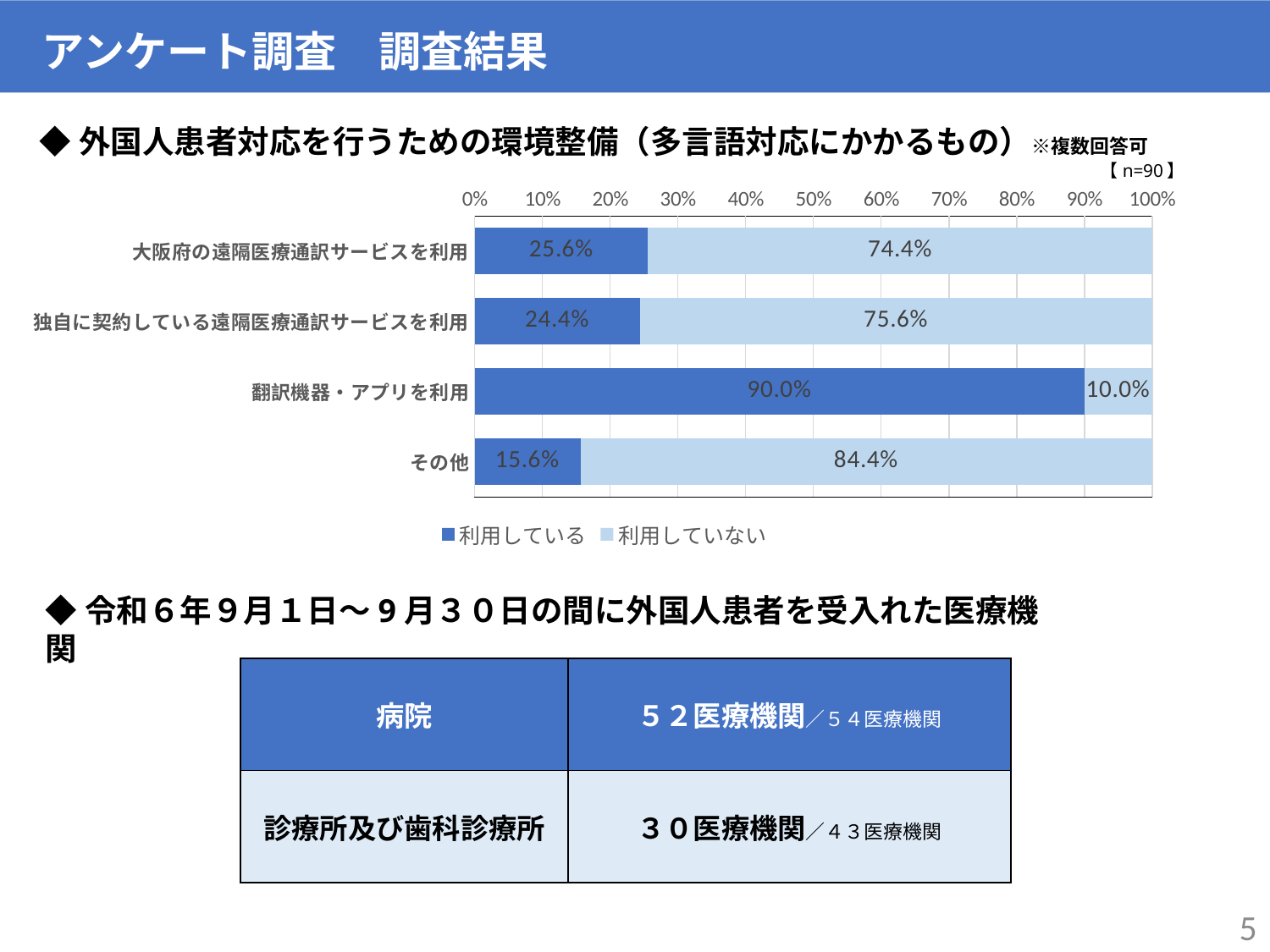
What is the 利用していない value for 大阪府の遠隔医療通訳サービスを利用? 74.4% How many categories are shown in the bar chart? 4 Which category has the highest 利用している share? 翻訳機器・アプリを利用 Which category has the lowest 利用している share? その他 What is the sample size (n) shown for the chart? n=90 What is the 利用していない value for 独自に契約している遠隔医療通訳サービスを利用? 75.6% What type of chart is shown on the slide? Stacked bar chart What is the difference between the 利用している values for 大阪府の遠隔医療通訳サービスを利用 and 独自に契約している遠隔医療通訳サービスを利用? 1.2% What is the 利用している value for その他? 15.6% What percentage of respondents use 翻訳機器・アプリ (利用している)? 90.0% Which is larger: the 利用している value for 大阪府の遠隔医療通訳サービスを利用 or for その他? 大阪府の遠隔医療通訳サービスを利用 How many series does the legend list? 2